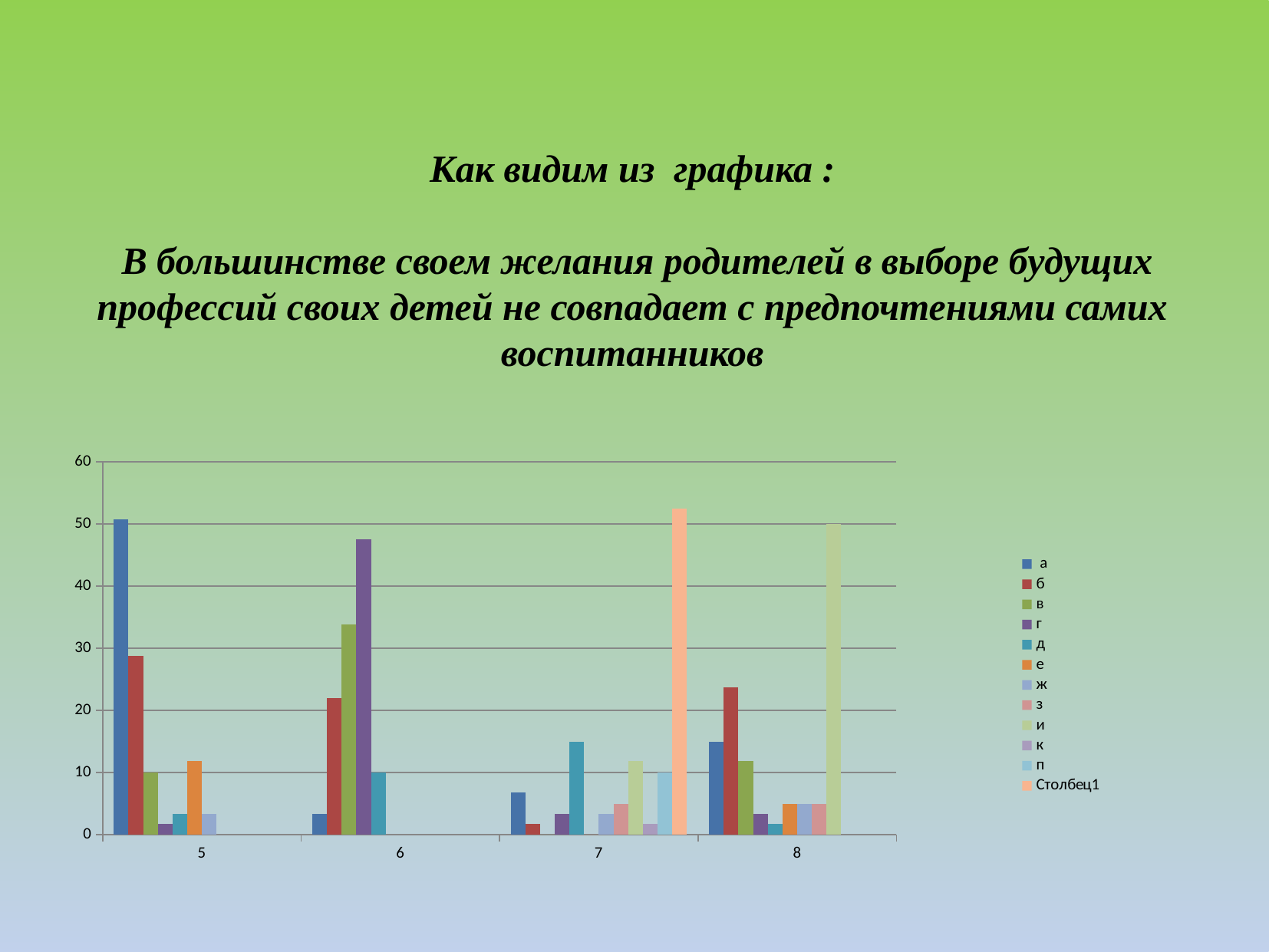
What is the last entry listed in the chart's legend? Столбец1 How many categories are shown on the x axis of the chart? 4 How many series does the chart's legend list? 12 Which series has the highest bar in category 7? Столбец1 Is the value for series а in category 5 greater or less than 40? greater What kind of chart is shown on the slide? bar chart Which series has the highest bar in category 8? и In category 6, which is larger: the bar for series г or the bar for series в? г Which series has the highest bar in category 6? г Is the value for series в in category 6 greater or less than 30? greater Is the value for series д in category 7 greater or less than 10? greater